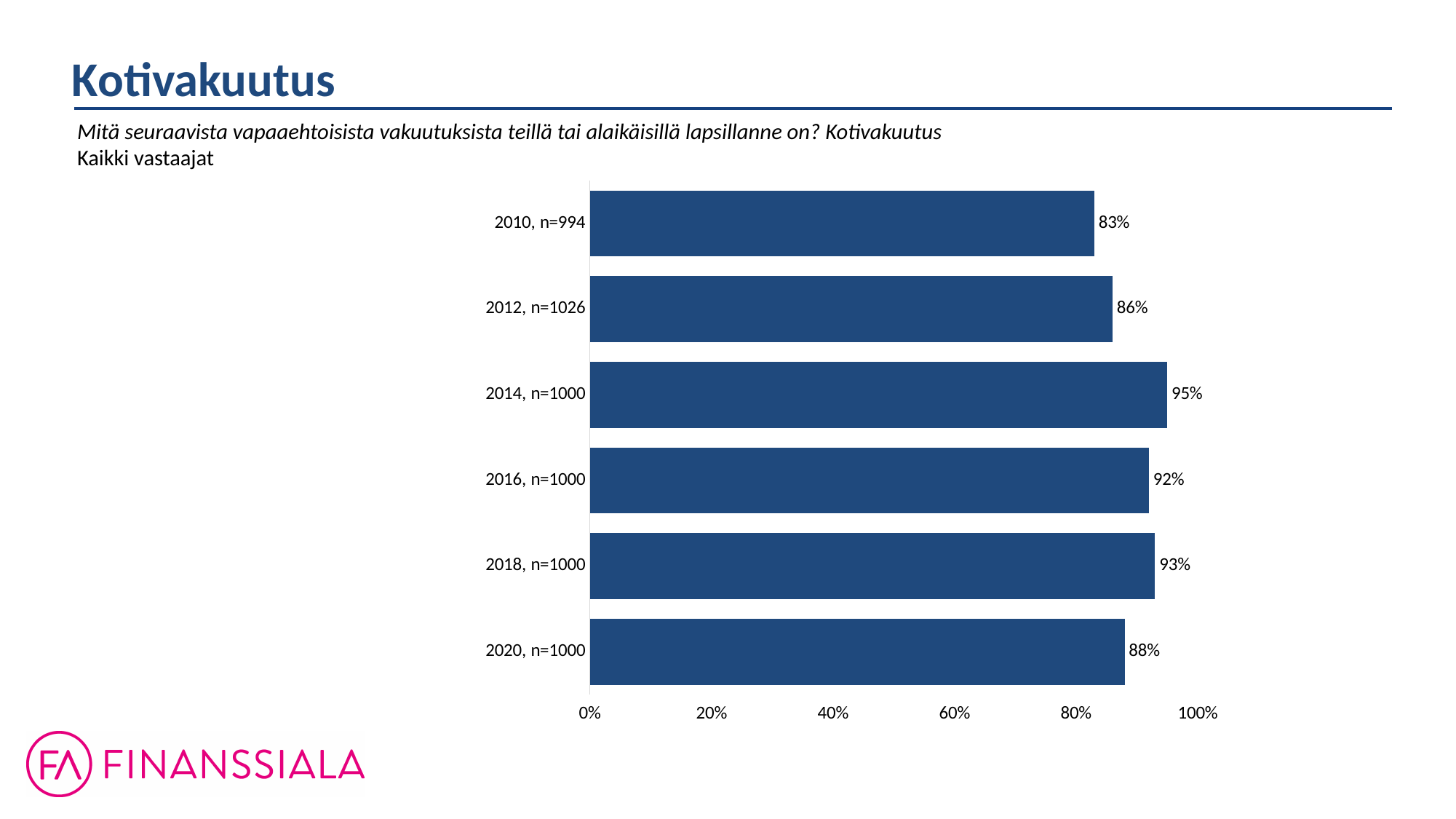
Which category has the highest value? 2014, n=1000 How many categories are shown in the chart? 6 Which is larger, the value for 2018, n=1000 or the value for 2020, n=1000? 2018, n=1000 What is the value for 2014, n=1000? 95% What is the value for 2010, n=994? 83% What is the difference between the values for 2016, n=1000 and 2012, n=1026? 6% What is the title of the slide? Kotivakuutus Which category has the lowest value? 2010, n=994 What kind of chart is shown on the slide? bar chart What is the difference between the values for 2014, n=1000 and 2010, n=994? 12% Is the value for 2012, n=1026 greater or less than 80%? greater What is the value for 2020, n=1000? 88%